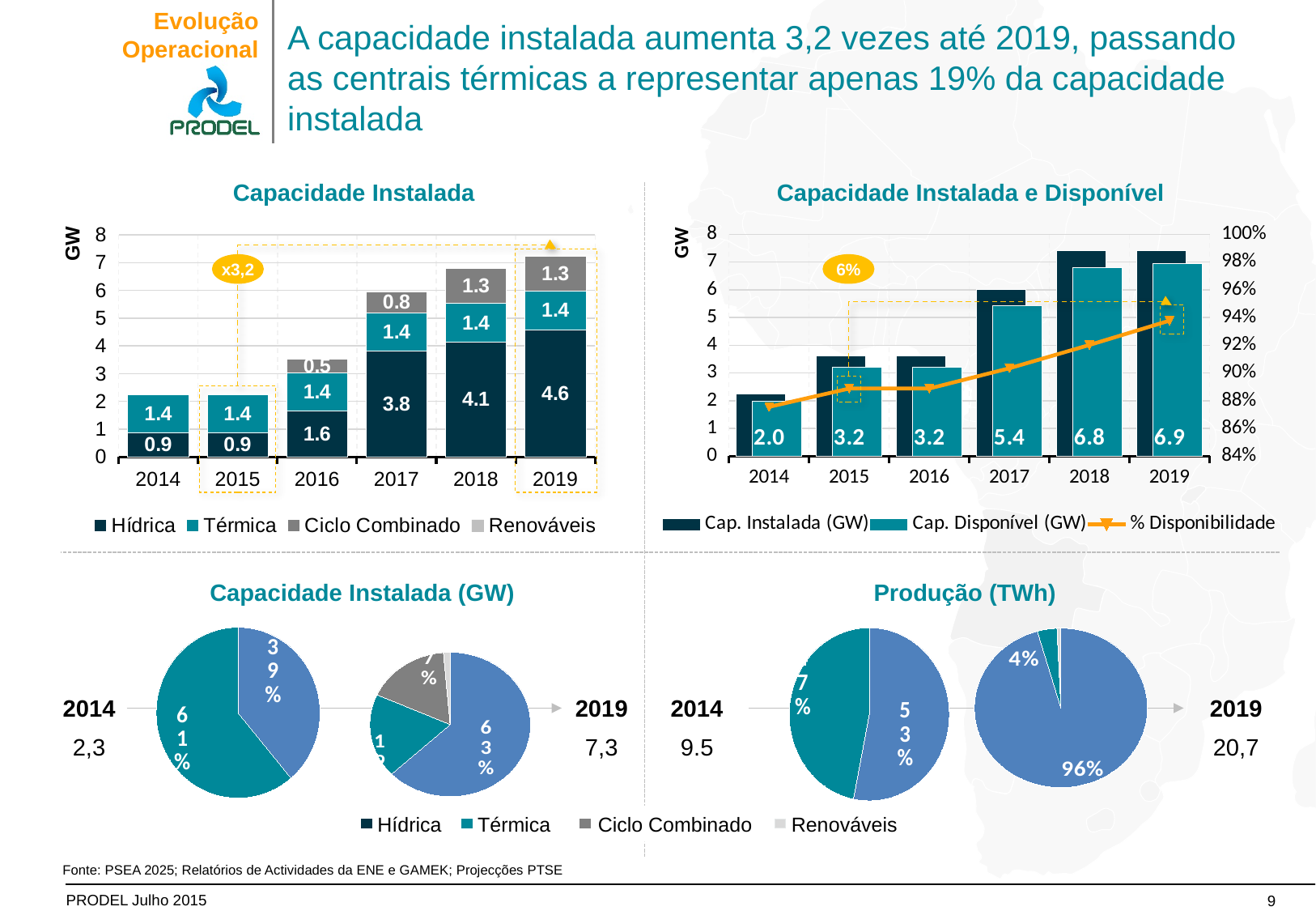
In the 'Capacidade Instalada' chart, how many series does the legend list? 4 In the 'Capacidade Instalada (GW)' pie charts, what share does Térmica have in 2014? 61% What kind of chart is the 'Capacidade Instalada e Disponível' chart? Bar chart with a line In the 'Capacidade Instalada e Disponível' chart, does Cap. Disponível (GW) rise or fall from 2014 to 2019? rise In the 'Capacidade Instalada' chart, what is the Hídrica value for 2019? 4.6 In the 'Capacidade Instalada' chart, how many years are shown on the x axis? 6 In the 'Capacidade Instalada e Disponível' chart, what is the Cap. Disponível (GW) value for 2018? 6.8 In the 'Capacidade Instalada' chart, what is the Ciclo Combinado value for 2018? 1.3 In the 'Capacidade Instalada e Disponível' chart, is the % Disponibilidade value for 2014 greater or less than 90%? less In the 'Produção (TWh)' pie charts, what share does Hídrica have in 2019? 96% In the 'Capacidade Instalada' chart, what is the difference between the Hídrica values for 2019 and 2014? 3.7 In the 'Capacidade Instalada' chart, which year has the highest Hídrica value? 2019